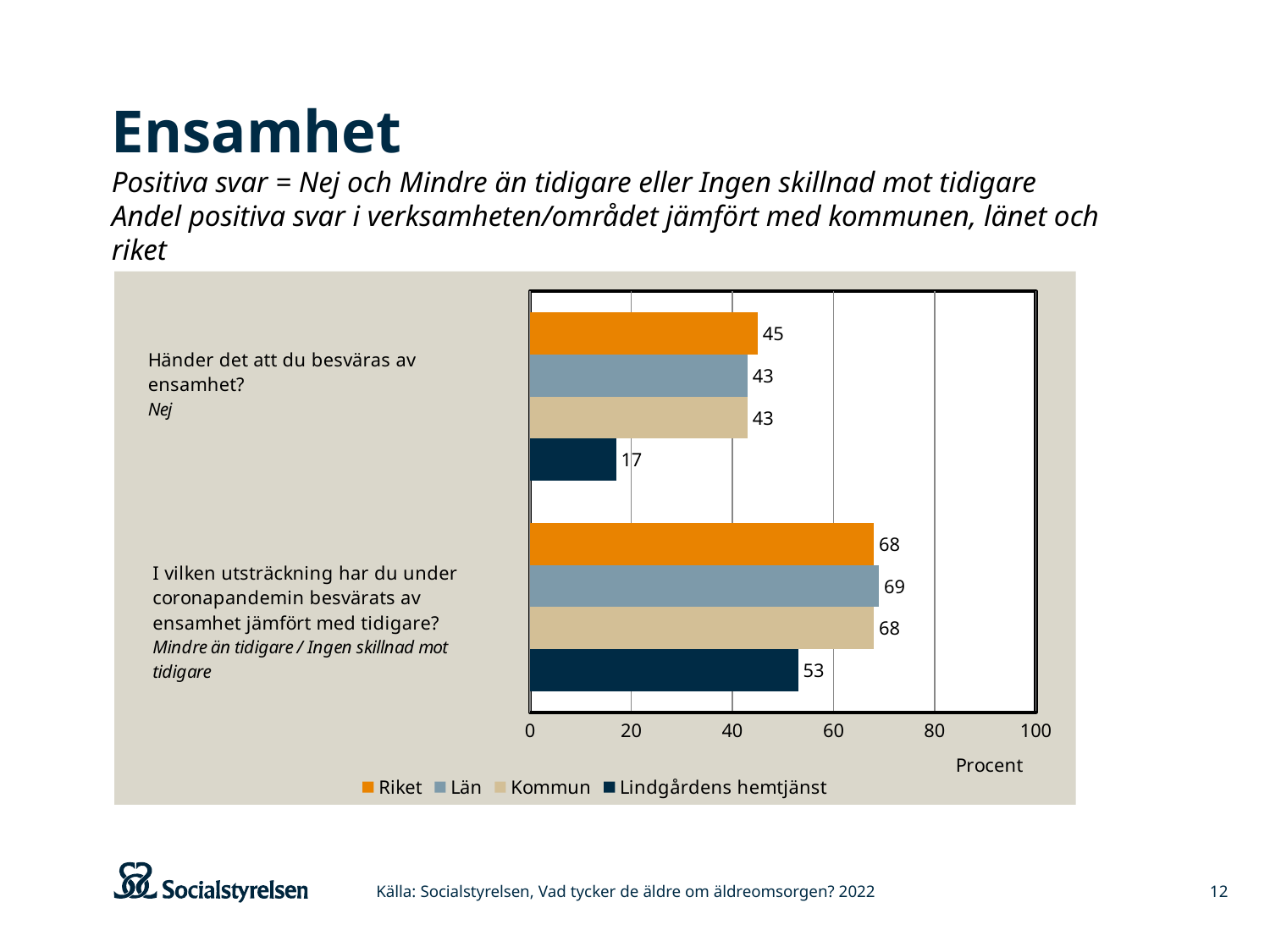
Which is larger on the question "Händer det att du besväras av ensamhet?": Riket or Kommun? Riket What is the value for Riket on the question "Händer det att du besväras av ensamhet?"? 45 What is the value for Lindgårdens hemtjänst on the question "I vilken utsträckning har du under coronapandemin besvärats av ensamhet jämfört med tidigare?"? 53 Which series has the lowest value on the question "Händer det att du besväras av ensamhet?"? Lindgårdens hemtjänst What is the difference between Kommun and Lindgårdens hemtjänst on the question "I vilken utsträckning har du under coronapandemin besvärats av ensamhet jämfört med tidigare?"? 15 Which series has the highest value on the question "I vilken utsträckning har du under coronapandemin besvärats av ensamhet jämfört med tidigare?"? Län How many series does the legend list? 4 What is the value for Län on the question "I vilken utsträckning har du under coronapandemin besvärats av ensamhet jämfört med tidigare?"? 69 What is the label of the x axis? Procent What is the difference between Riket and Lindgårdens hemtjänst on the question "Händer det att du besväras av ensamhet?"? 28 What kind of chart is shown on the slide? Bar chart What is the value for Lindgårdens hemtjänst on the question "Händer det att du besväras av ensamhet?"? 17